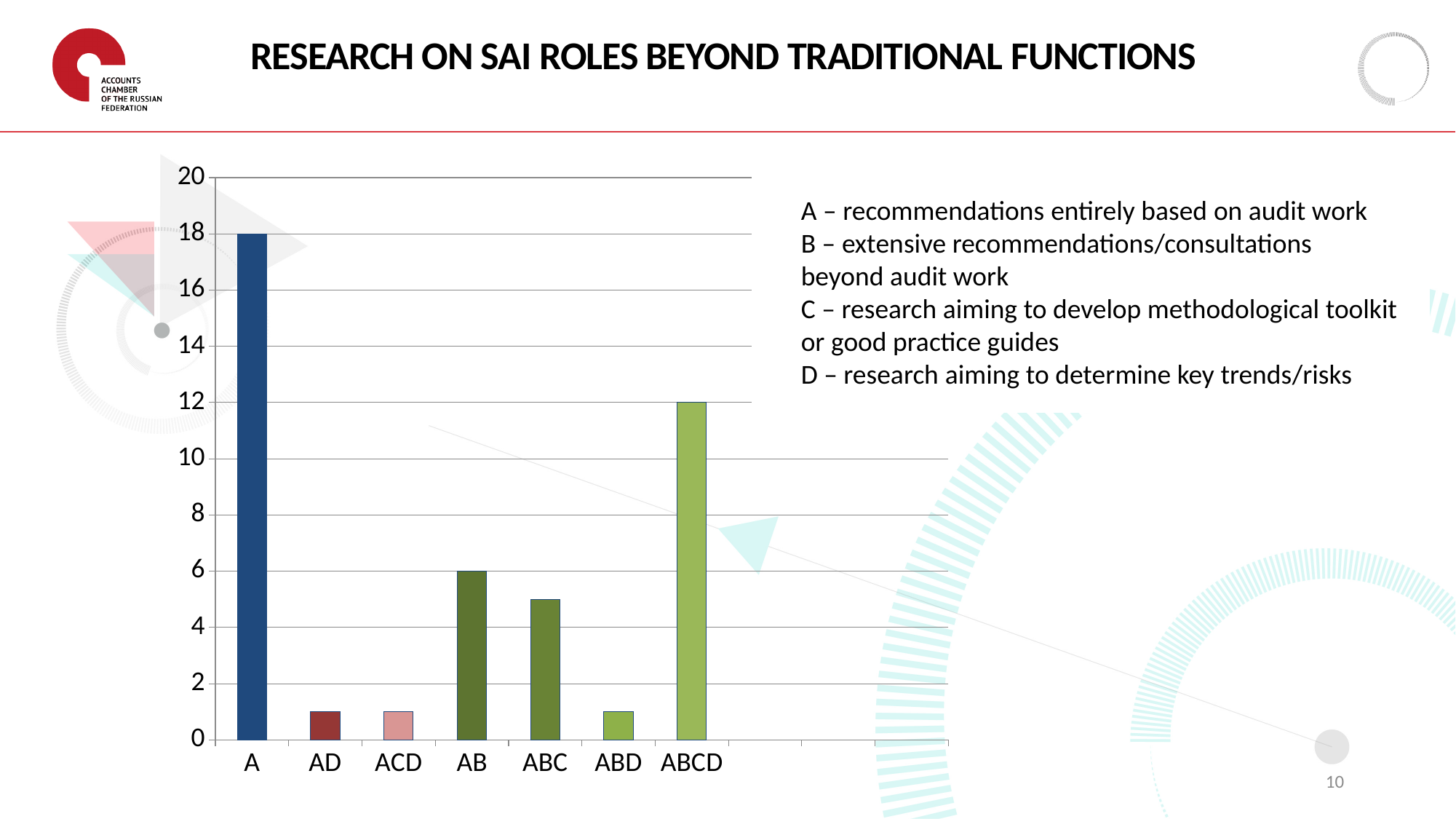
What is the value for category AB? 6 What kind of chart is shown on the slide? bar chart What is the difference between the values for A and ABCD? 6 What is the value for category A? 18 How many categories are shown on the x axis? 7 What is the title of the slide containing the chart? RESEARCH ON SAI ROLES BEYOND TRADITIONAL FUNCTIONS What is the value for category ABCD? 12 Which category has the highest value? A Which is larger, the value for AB or the value for ABCD? ABCD Is the value for AD greater or less than 2? less Is the value for ABC greater or less than 4? greater What is the difference between the values for A and AB? 12